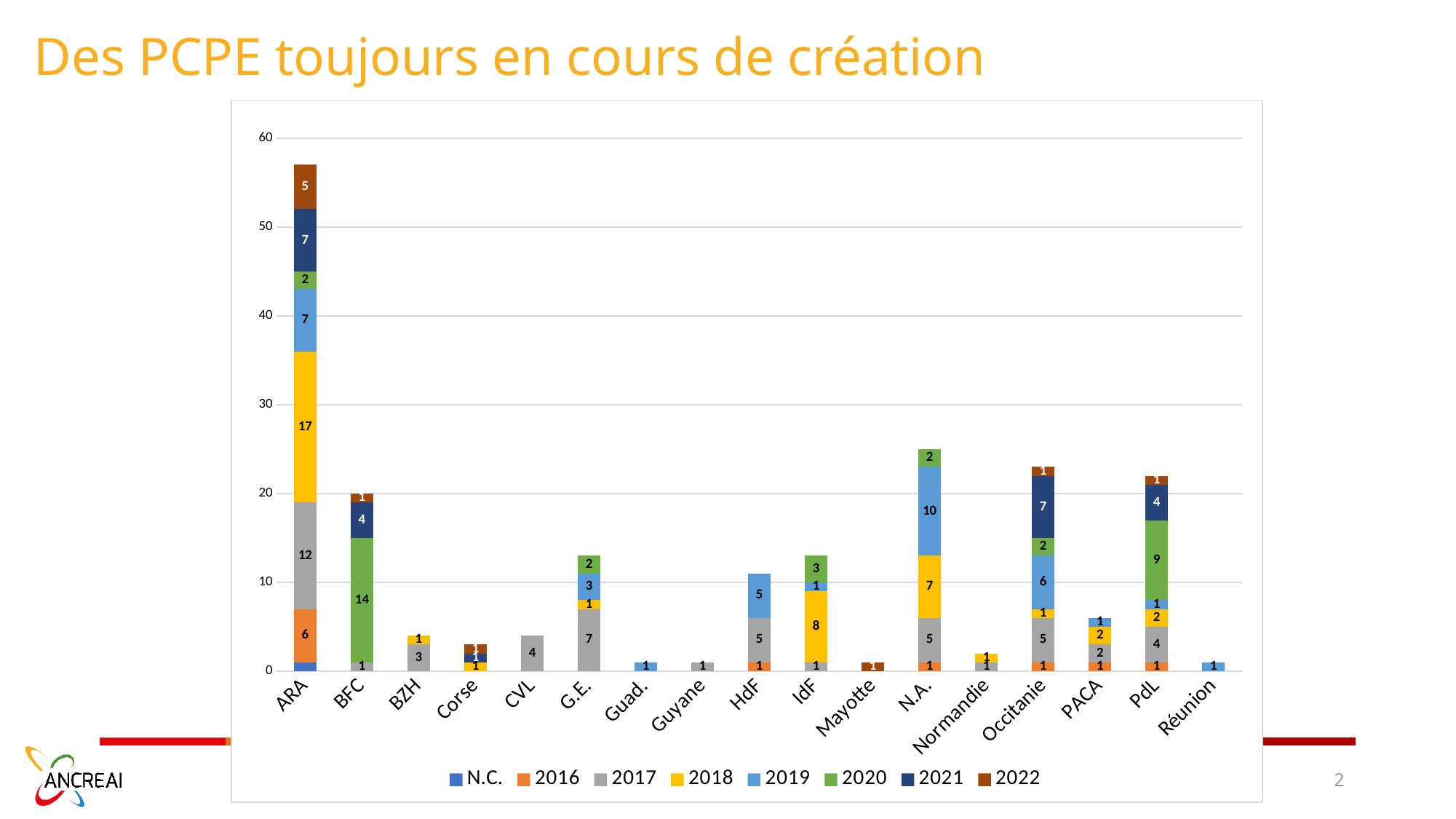
What is the value of the 2021 segment for Occitanie? 7 Which region has the tallest stacked bar? ARA What is the value of the 2018 segment for ARA? 17 What is the difference between the 2018 segment for IdF and the 2018 segment for N.A.? 1 What is the total of the stacked bar for PdL? 22 How many series does the legend list? 8 What type of chart is shown on the slide? stacked bar chart What is the value of the 2019 segment for N.A.? 10 What is the total of the stacked bar for ARA? 57 How many regions (categories) are shown on the x axis? 17 Which is larger: the 2020 segment for PdL or the 2019 segment for Occitanie? 2020 segment for PdL What is the value of the 2020 segment for BFC? 14